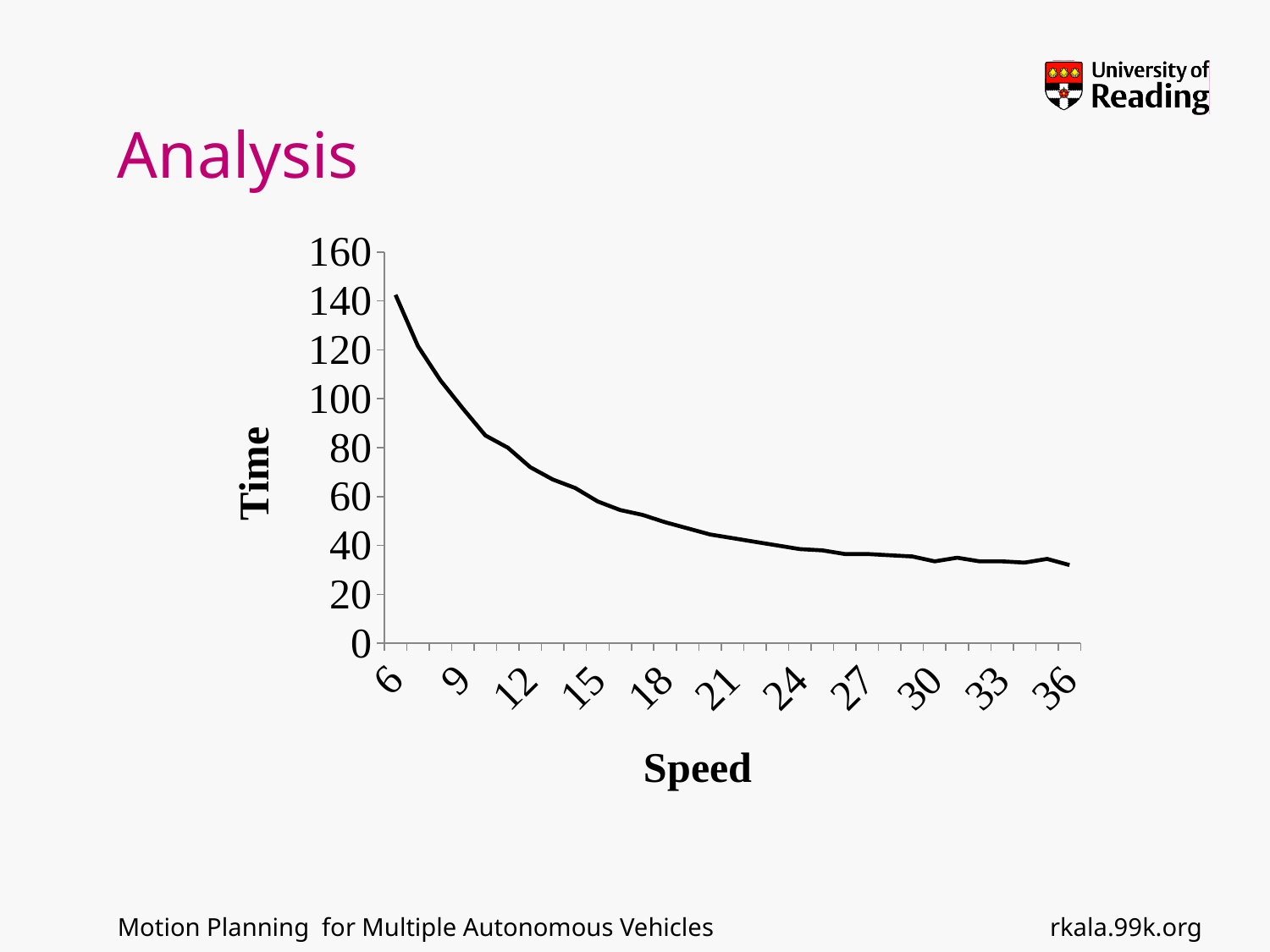
Is the Time value at Speed 21 greater or less than 60? less Which has the larger Time value, Speed 9 or Speed 27? Speed 9 At which Speed value is Time highest? 6 Is the Time value at Speed 36 greater or less than 40? less Does Time rise or fall as Speed increases along the x axis? fall What kind of chart is shown on the slide? line chart What is the label of the x axis? Speed What is the label of the y axis? Time Is the Time value at Speed 9 greater or less than 80? greater At which Speed value is Time lowest? 36